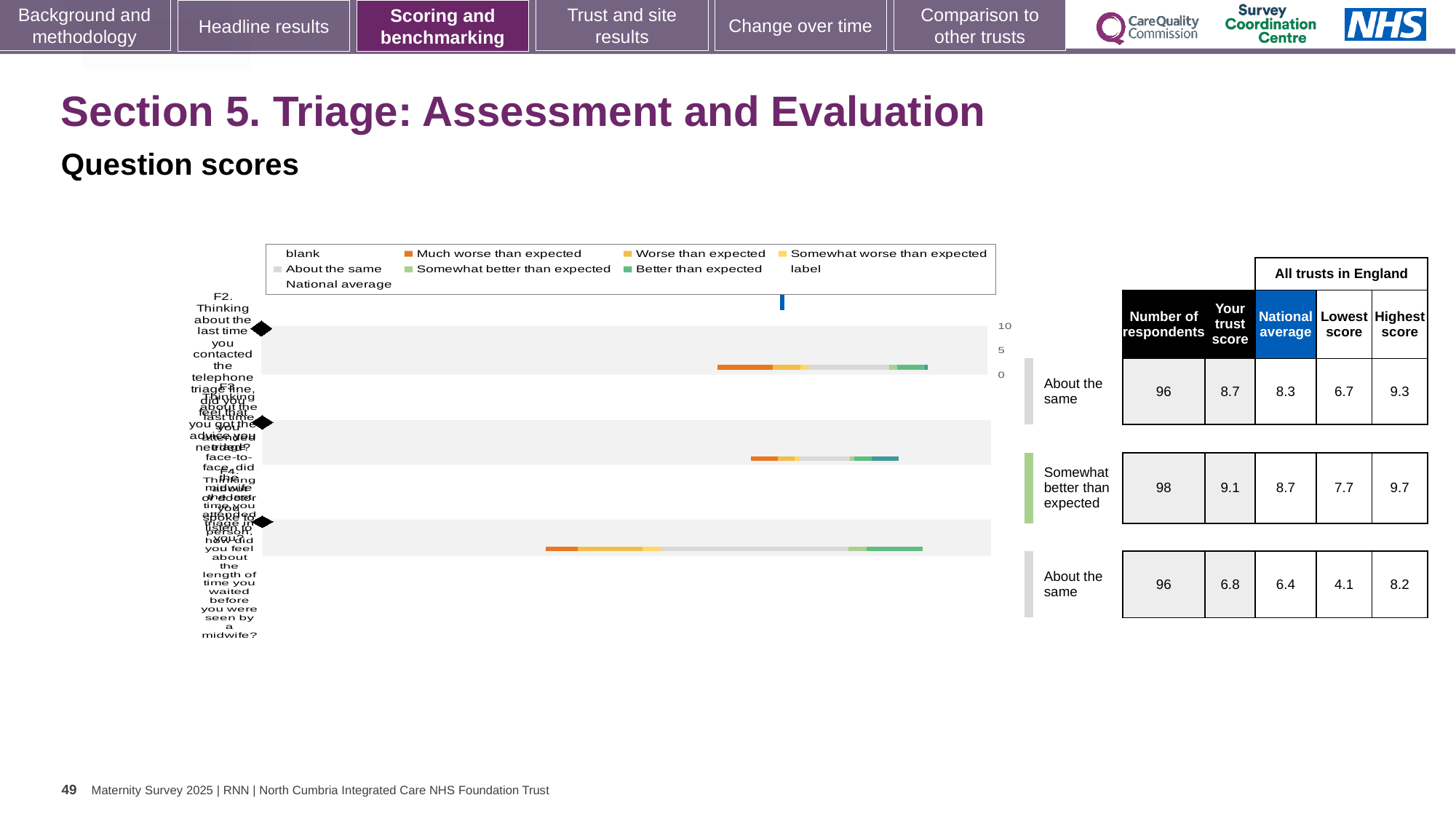
What kind of chart is shown on the slide? Bar chart For the top row, is the trust score higher or lower than the national average? Higher Which row of the chart has the highest 'Your trust score'? The middle row (9.1) What is the national average for the middle row of the chart? 8.7 For the bottom row, what is the difference between the trust score and the national average? 0.4 How many respondents are listed for the bottom row of the chart? 96 Which row of the chart has the lowest 'Your trust score'? The bottom row (6.8) Which legend entry is shown in dark orange? Much worse than expected What is the maximum value shown on the chart's x axis? 10 What is the 'Your trust score' for the top row (F2) of the chart? 8.7 What is the highest score across all trusts in England for the middle row? 9.7 How many question rows (bars) are plotted in the chart? 3